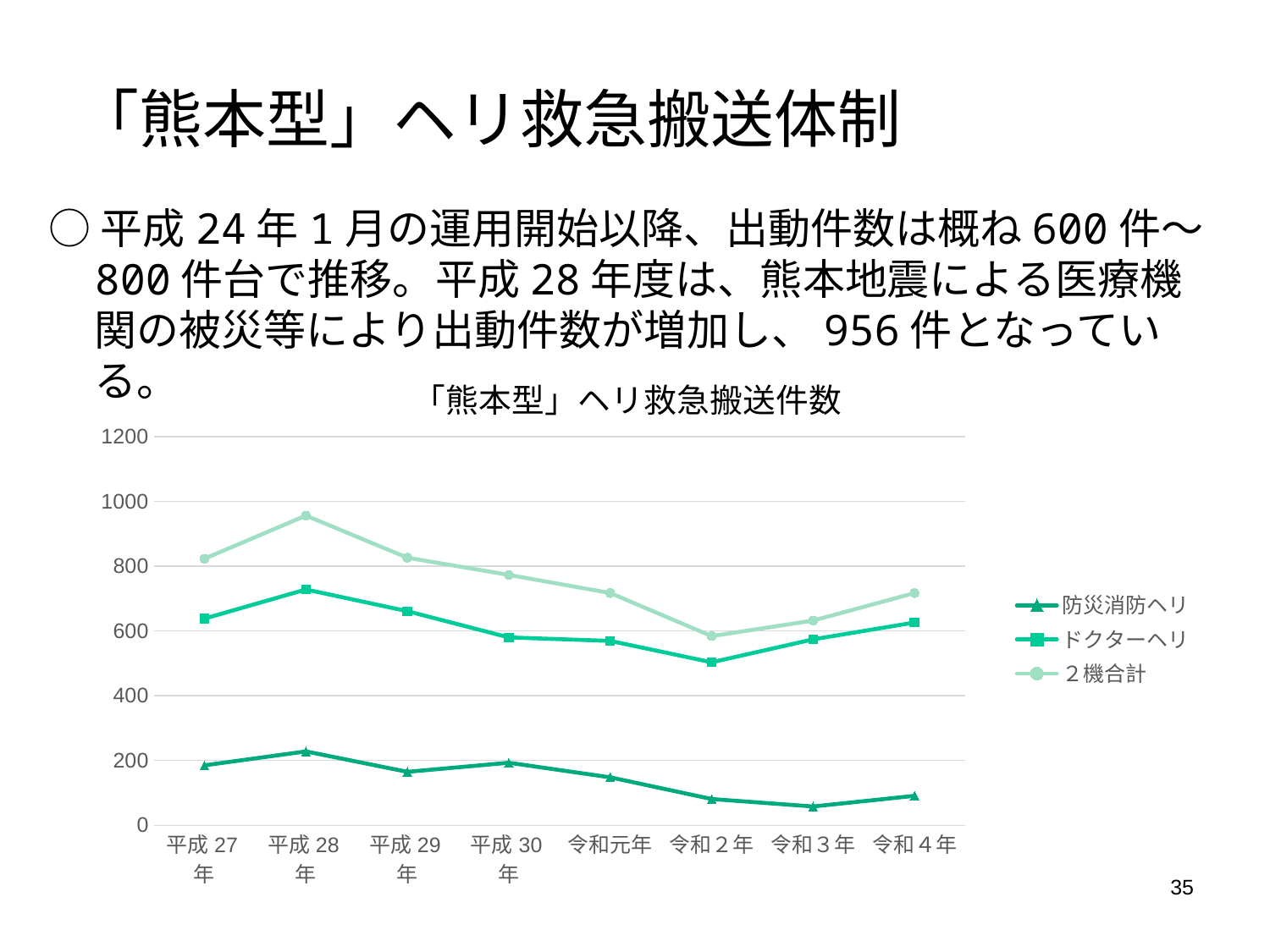
What kind of chart is shown on the slide? line chart How many years are plotted along the x axis? 8 In which year is the 2機合計 series at its highest? 平成28年 Which series has the larger value in 令和4年, ドクターヘリ or 防災消防ヘリ? ドクターヘリ What is the title of the chart? 「熊本型」ヘリ救急搬送件数 Does the 2機合計 series rise or fall from 平成28年 to 令和2年? fall Is the value for 防災消防ヘリ in 令和3年 greater or less than 200? less In which year is the 2機合計 series at its lowest? 令和2年 In which year is the 防災消防ヘリ series at its lowest? 令和3年 Is the value for ドクターヘリ in 平成28年 greater or less than 600? greater How many series does the legend list? 3 Is the value for 2機合計 in 平成28年 greater or less than 800? greater